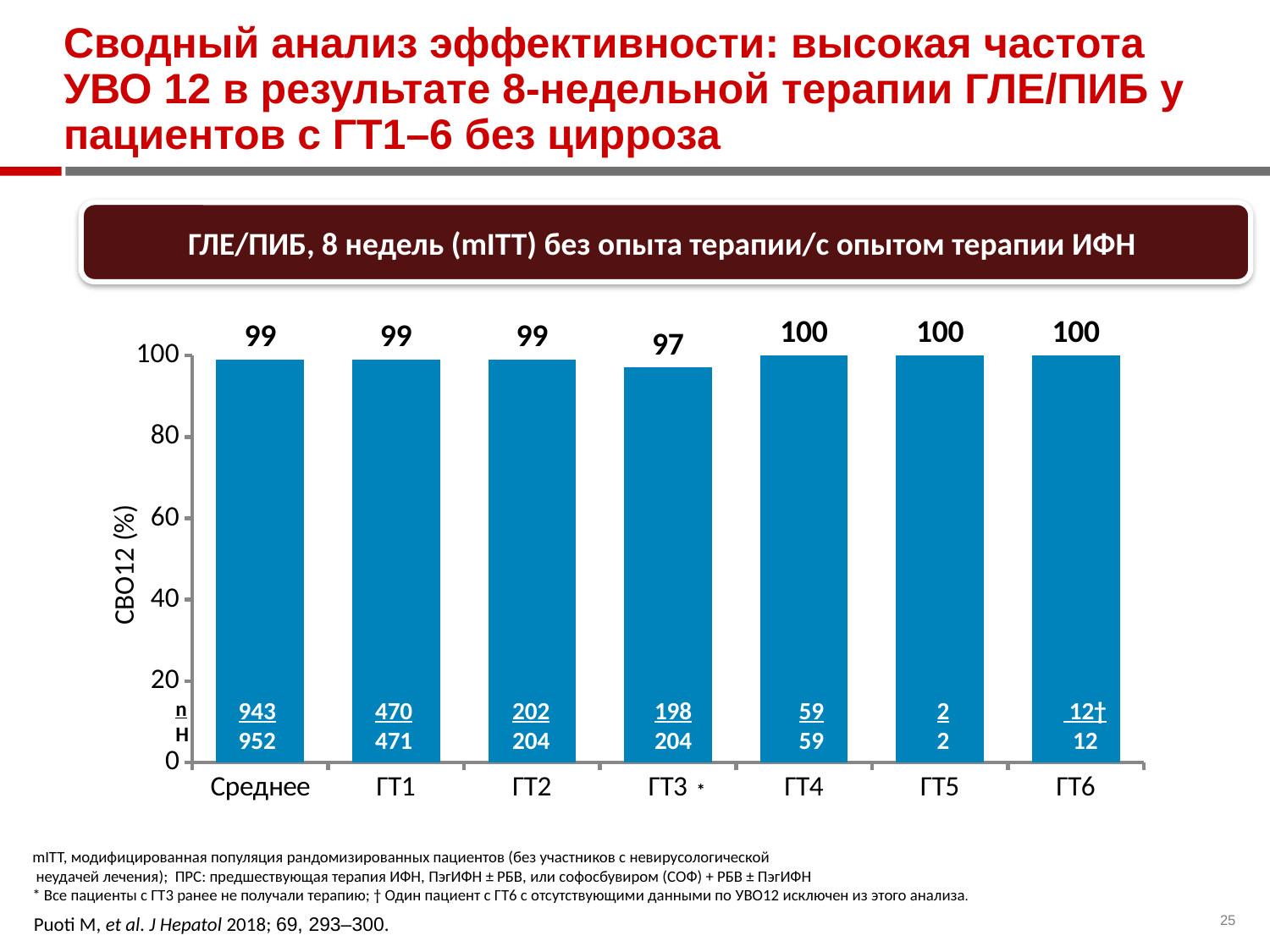
What is the СВО12 (%) value for ГТ4? 100 What is the СВО12 (%) value for Среднее? 99 Which category has the lowest СВО12 (%) value? ГТ3 What kind of chart is shown on the slide? bar chart How many categories are shown on the x axis? 7 What is the n/N shown inside the bar for Среднее? 943/952 Is the value for ГТ3 greater or less than 80? greater What is the difference between the СВО12 values for ГТ1 and ГТ3? 2 What is the label of the y axis? СВО12 (%) What is the СВО12 (%) value for ГТ3? 97 Which is larger, the СВО12 value for ГТ2 or for ГТ5? ГТ5 What is the n/N shown inside the bar for ГТ1? 470/471